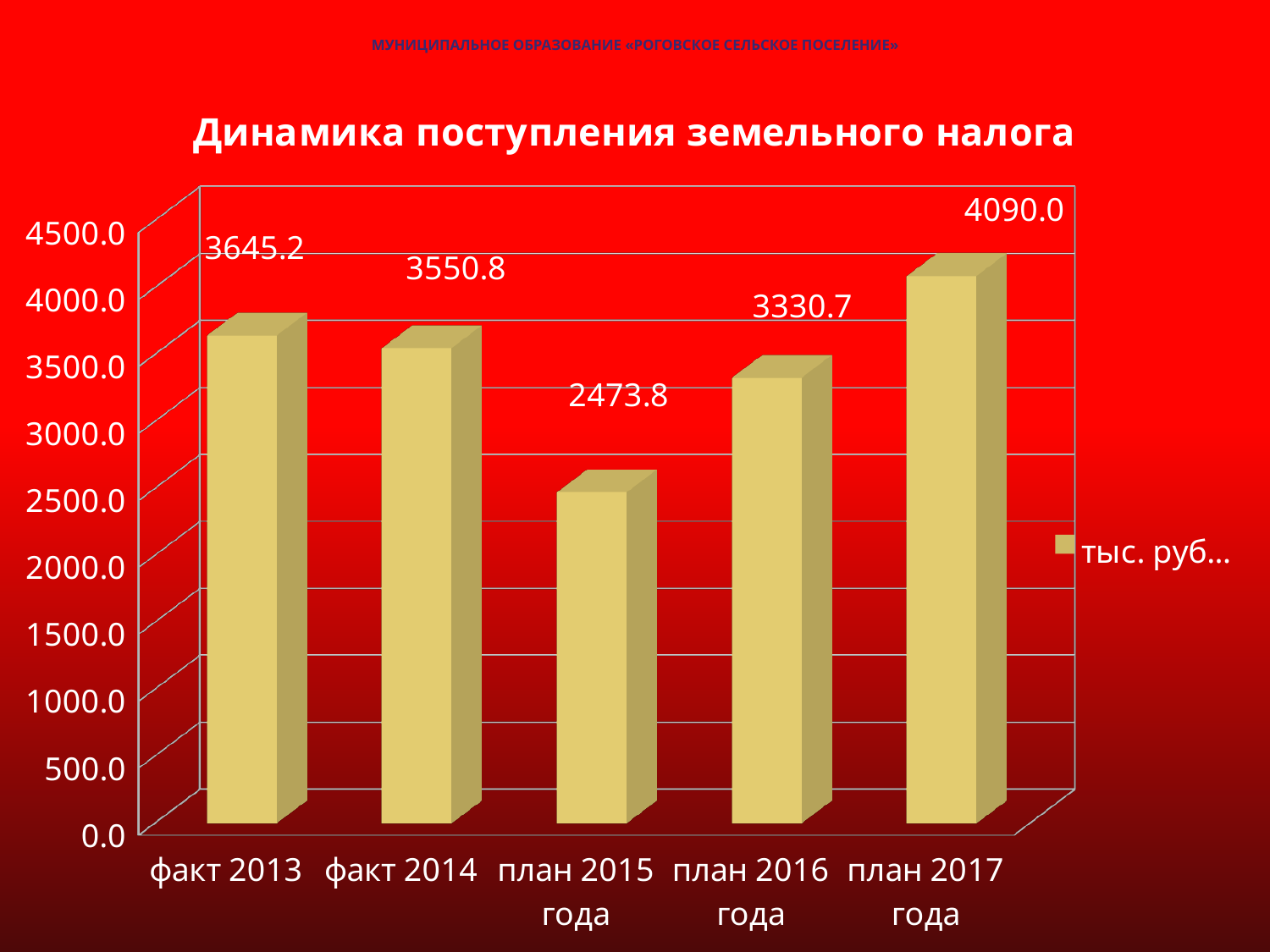
Which category has the highest value? план 2017 года What is the title of the chart? Динамика поступления земельного налога Is the value for план 2016 года greater or less than 3000.0? greater What kind of chart is shown on the slide? bar chart Which is larger, the value for факт 2014 or the value for план 2016 года? факт 2014 What is the difference between the values for план 2017 года and план 2016 года? 759.3 What is the difference between the values for факт 2013 and факт 2014? 94.4 What is the value for факт 2013? 3645.2 What is the value for план 2017 года? 4090.0 Which category has the lowest value? план 2015 года What is the value for план 2015 года? 2473.8 How many categories are shown on the x axis? 5